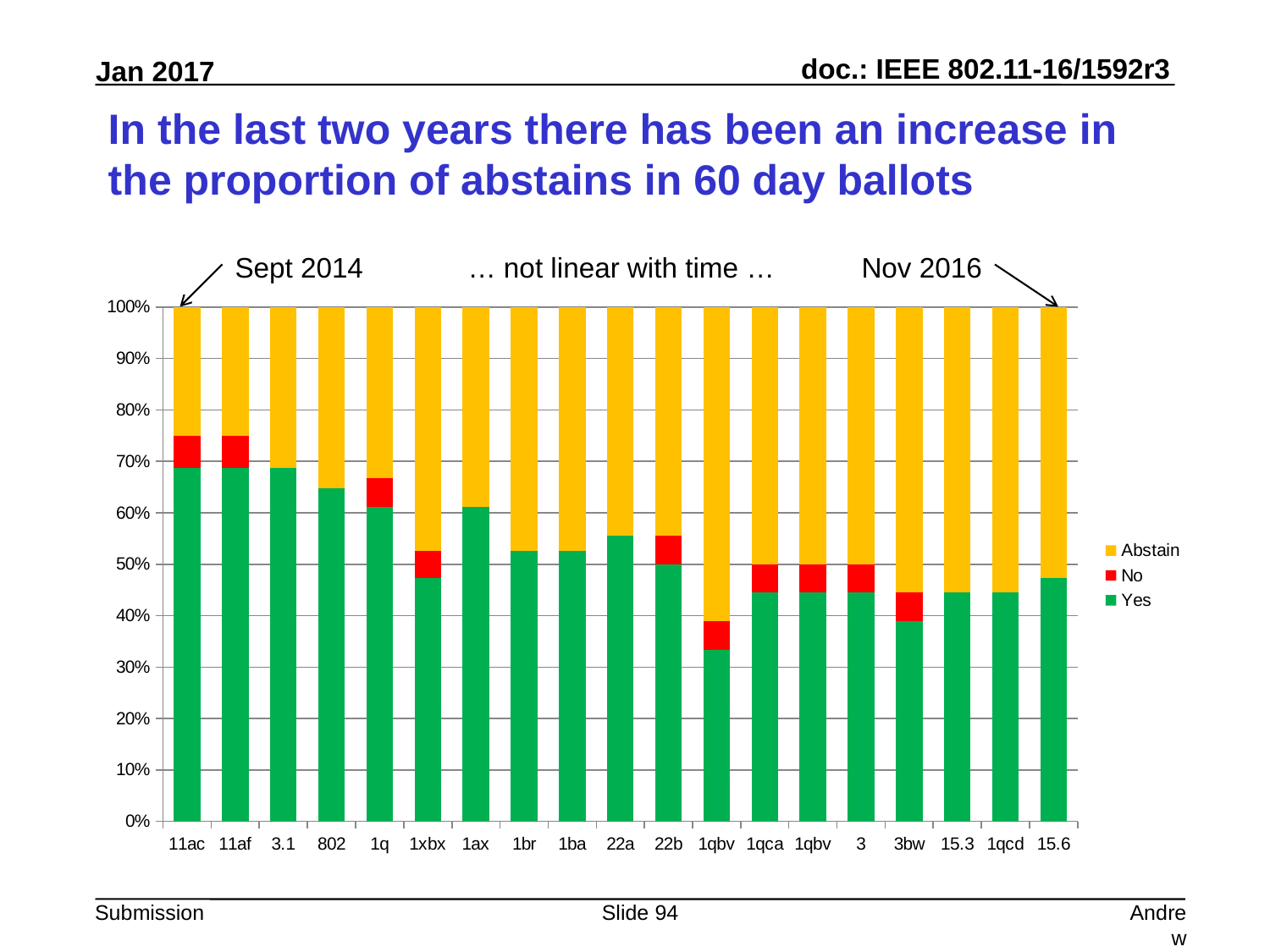
Which colour represents the Abstain series in the chart? Yellow What kind of chart is shown on the slide? Stacked bar chart What are the three series listed in the legend? Abstain, No, Yes Which ballot has the largest Abstain proportion? 1qbv Which ballot has the lowest Yes proportion? 1qbv Is the Yes proportion for 1xbx greater or less than 50%? less How many ballots (categories) are shown along the x axis? 19 Is the Yes proportion for 11ac greater or less than 60%? greater Is the Yes proportion for 802 greater or less than 60%? greater How many series does the legend list? 3 Which has the larger Yes proportion, 11ac or 1qbv? 11ac